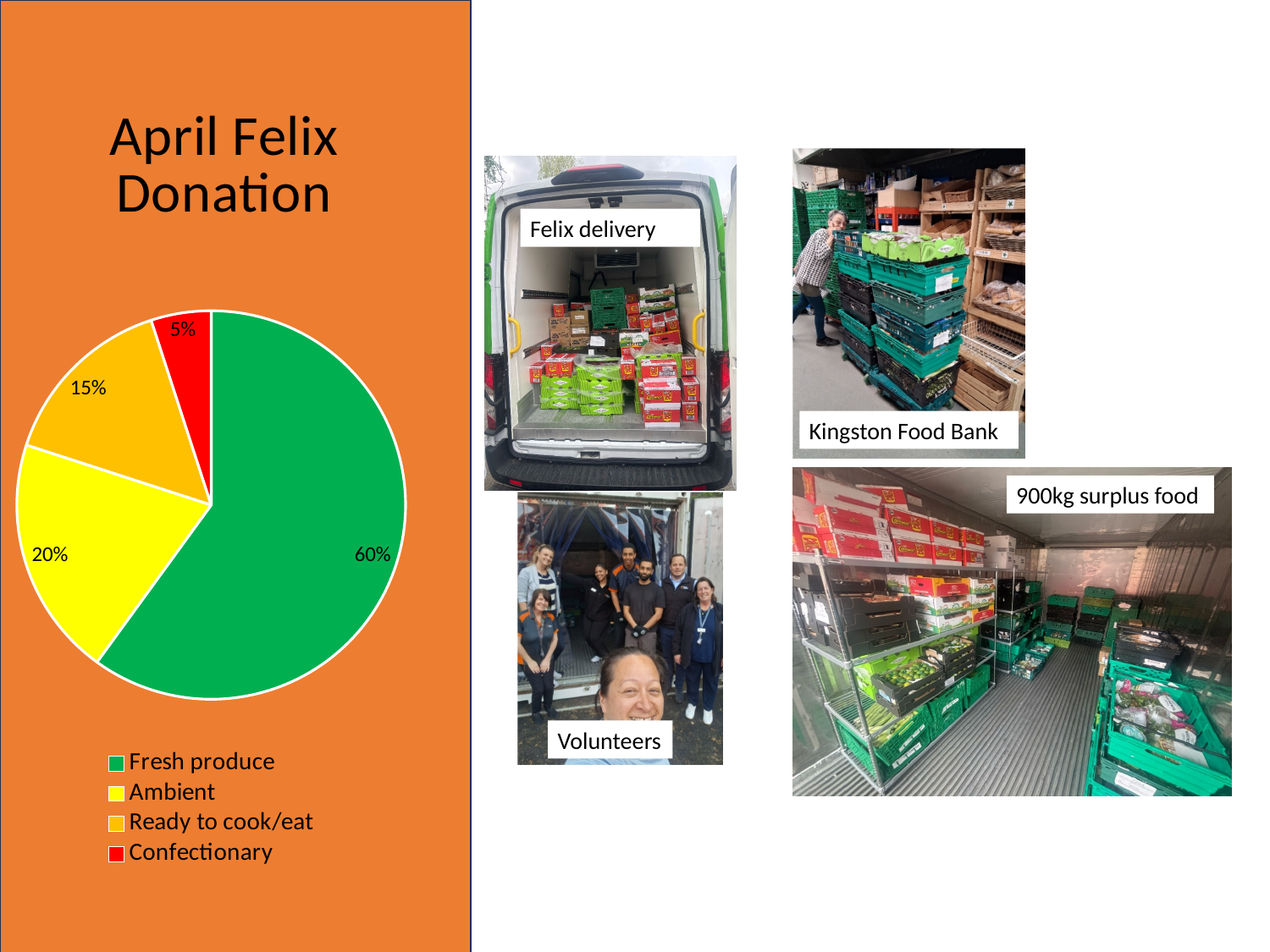
What percentage of the pie is Confectionary? 5% What is the difference in percentage points between Fresh produce and Ambient? 40 What percentage of the pie is Fresh produce? 60% Which category has the smallest share of the pie? Confectionary What percentage of the pie is Ready to cook/eat? 15% Which is larger, the share for Ambient or the share for Ready to cook/eat? Ambient What kind of chart is shown on the slide? Pie chart What colour is the Confectionary slice? Red How many categories does the legend list? 4 What is the title of the chart? April Felix Donation What percentage of the pie is Ambient? 20% Which category has the largest share of the pie? Fresh produce